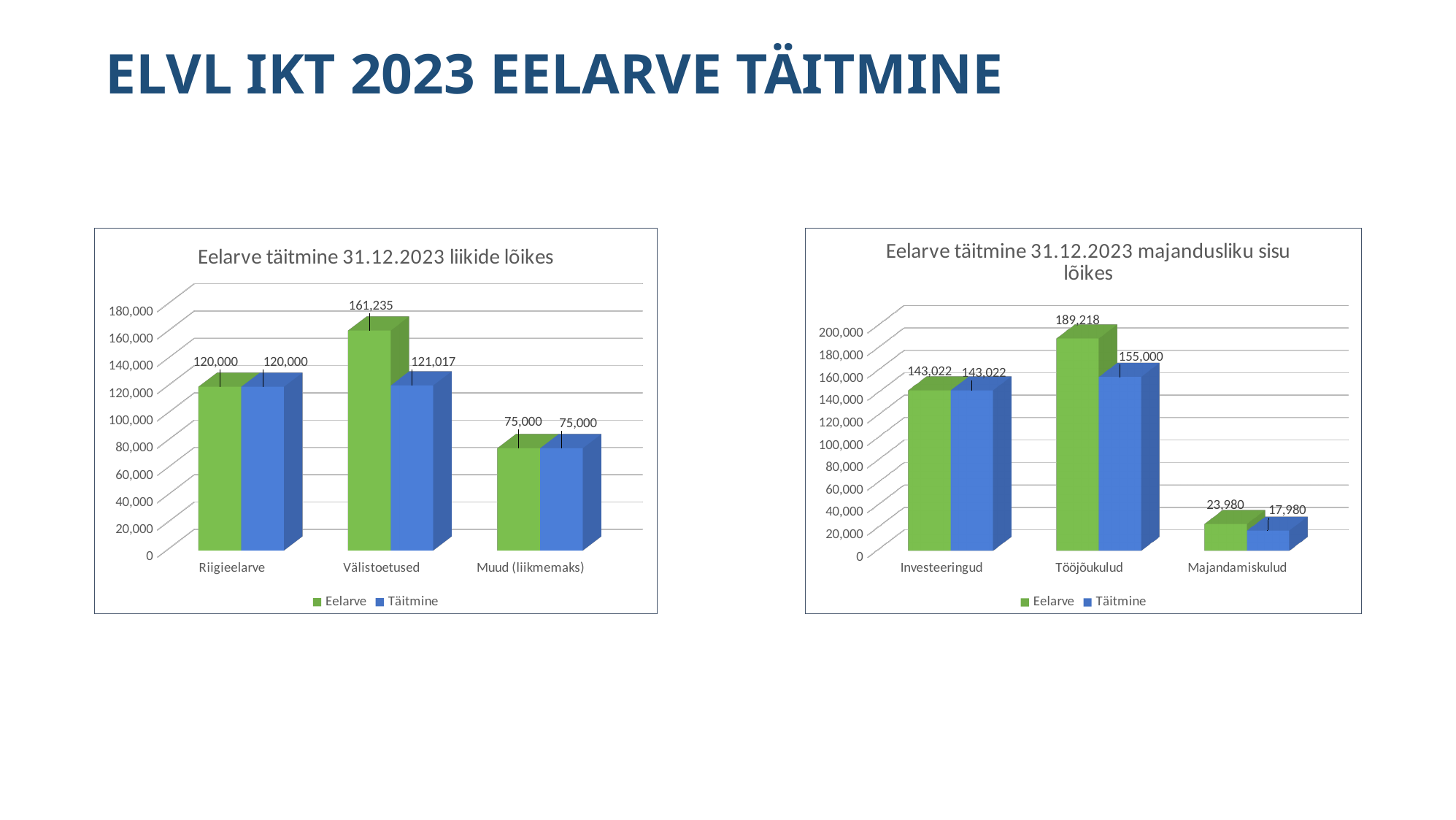
In the left chart (Eelarve täitmine 31.12.2023 liikide lõikes), which category has the lowest Eelarve value? Muud (liikmemaks) In the left chart (Eelarve täitmine 31.12.2023 liikide lõikes), how many series does the legend list? 2 In the left chart (Eelarve täitmine 31.12.2023 liikide lõikes), what is the Eelarve value for Välistoetused? 161,235 In the right chart (Eelarve täitmine 31.12.2023 majandusliku sisu lõikes), what is the difference between the Eelarve and Täitmine values for Tööjõukulud? 34,218 In the left chart (Eelarve täitmine 31.12.2023 liikide lõikes), how many categories are shown on the x axis? 3 In the right chart (Eelarve täitmine 31.12.2023 majandusliku sisu lõikes), what is the Täitmine value for Majandamiskulud? 17,980 In the right chart (Eelarve täitmine 31.12.2023 majandusliku sisu lõikes), which category has the highest Täitmine value? Tööjõukulud In the right chart (Eelarve täitmine 31.12.2023 majandusliku sisu lõikes), which is larger: the Eelarve value for Investeeringud or the Täitmine value for Tööjõukulud? Täitmine value for Tööjõukulud In the left chart (Eelarve täitmine 31.12.2023 liikide lõikes), what is the difference between the Eelarve and Täitmine values for Välistoetused? 40,218 In the left chart (Eelarve täitmine 31.12.2023 liikide lõikes), what is the Täitmine value for Välistoetused? 121,017 In the right chart (Eelarve täitmine 31.12.2023 majandusliku sisu lõikes), what is the Eelarve value for Tööjõukulud? 189,218 What kind of chart is the right chart (Eelarve täitmine 31.12.2023 majandusliku sisu lõikes)? Bar chart